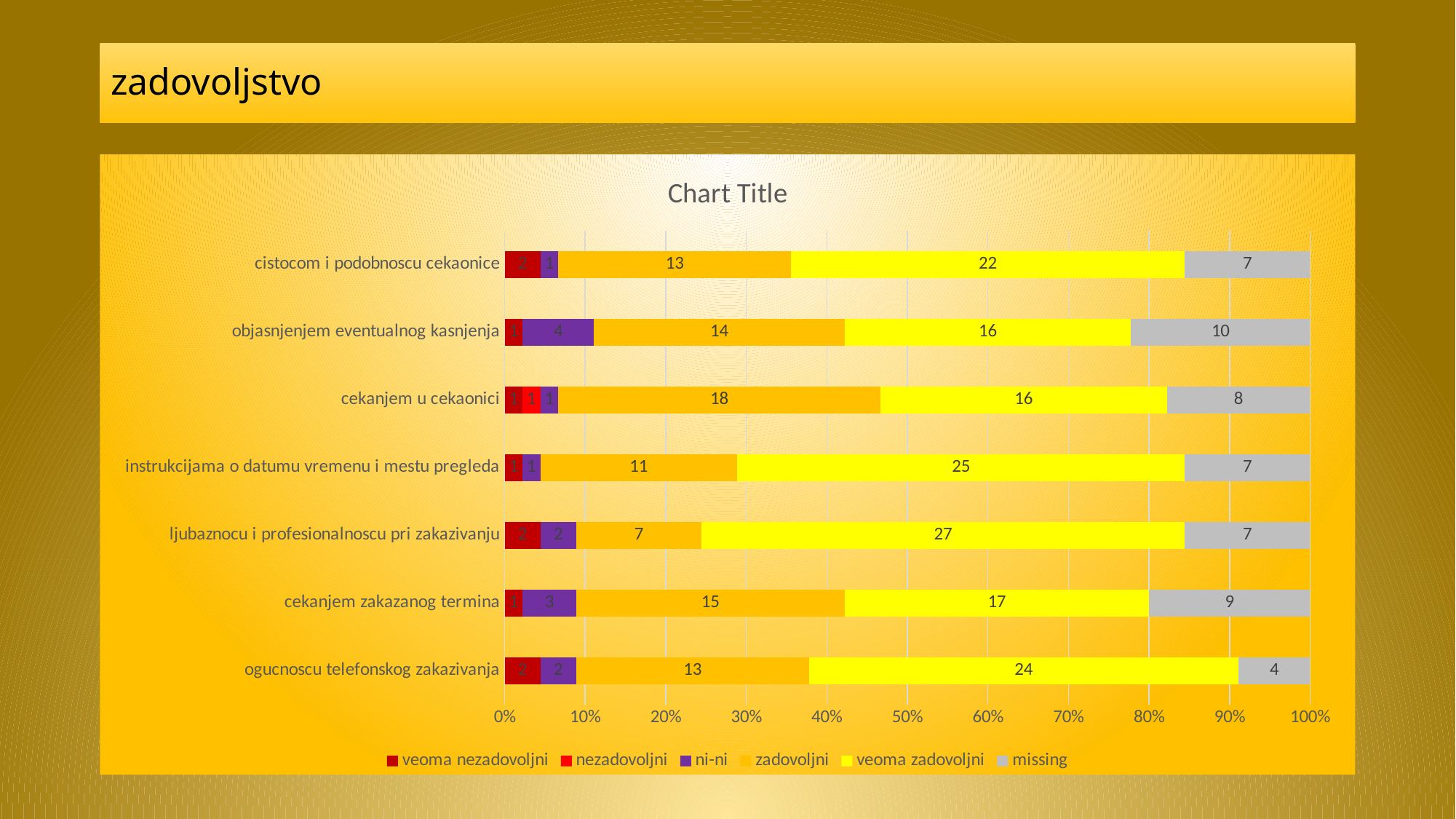
What is the difference between the 'veoma zadovoljni' values for 'instrukcijama o datumu vremenu i mestu pregleda' and 'cekanjem zakazanog termina'? 8 Which category has the highest 'veoma zadovoljni' value? ljubaznocu i profesionalnoscu pri zakazivanju Which is larger: the 'zadovoljni' value for 'cekanjem zakazanog termina' or for 'cistocom i podobnoscu cekaonice'? cekanjem zakazanog termina How many categories are shown on the chart? 7 What is the 'zadovoljni' value for 'cekanjem u cekaonici'? 18 How many series does the legend list? 6 Which category has the lowest 'missing' value? ogucnoscu telefonskog zakazivanja What is the total of all segments in the bar for 'ogucnoscu telefonskog zakazivanja'? 45 What kind of chart is shown on the slide? stacked bar chart What is the title shown above the chart? Chart Title What is the 'missing' value for 'objasnjenjem eventualnog kasnjenja'? 10 What is the 'veoma zadovoljni' value for 'ljubaznocu i profesionalnoscu pri zakazivanju'? 27